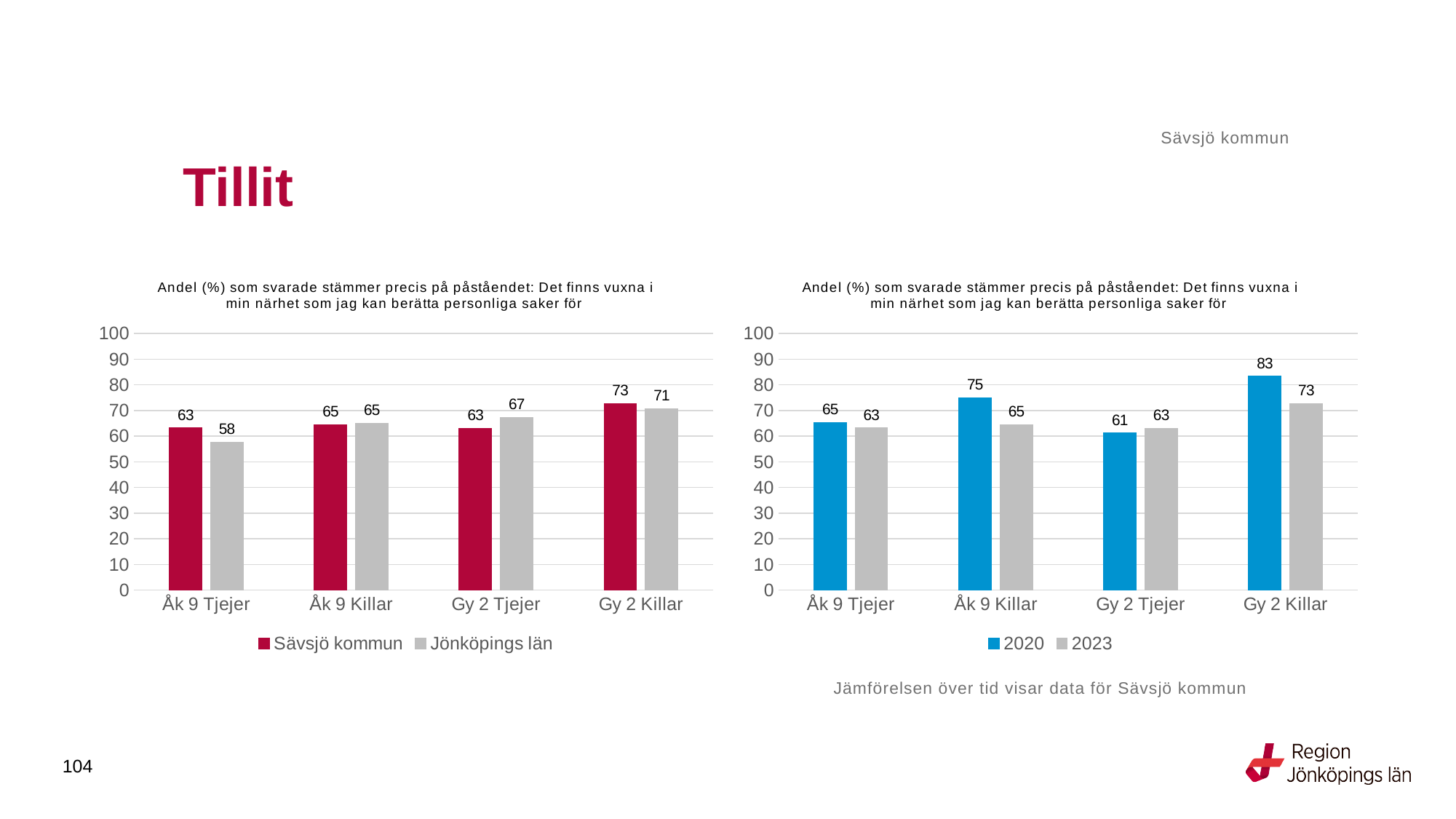
In the right chart, which category has the lowest value for 2020? Gy 2 Tjejer In the left chart, what is the difference between Sävsjö kommun and Jönköpings län for Åk 9 Tjejer? 5 In the left chart, what is the value for Sävsjö kommun for Åk 9 Tjejer? 63 In the right chart, what is the difference between 2020 and 2023 for Åk 9 Killar? 10 In the right chart, what is the value for 2023 for Gy 2 Tjejer? 63 How many series does the legend of the right chart list? 2 In the left chart, which category has the lowest value for Jönköpings län? Åk 9 Tjejer In the left chart, what is the value for Jönköpings län for Gy 2 Killar? 71 In the left chart, which is larger for Gy 2 Tjejer: Sävsjö kommun or Jönköpings län? Jönköpings län In the right chart, what is the value for 2020 for Gy 2 Killar? 83 In the left chart, which category has the highest value for Sävsjö kommun? Gy 2 Killar What kind of chart is the left chart? Bar chart